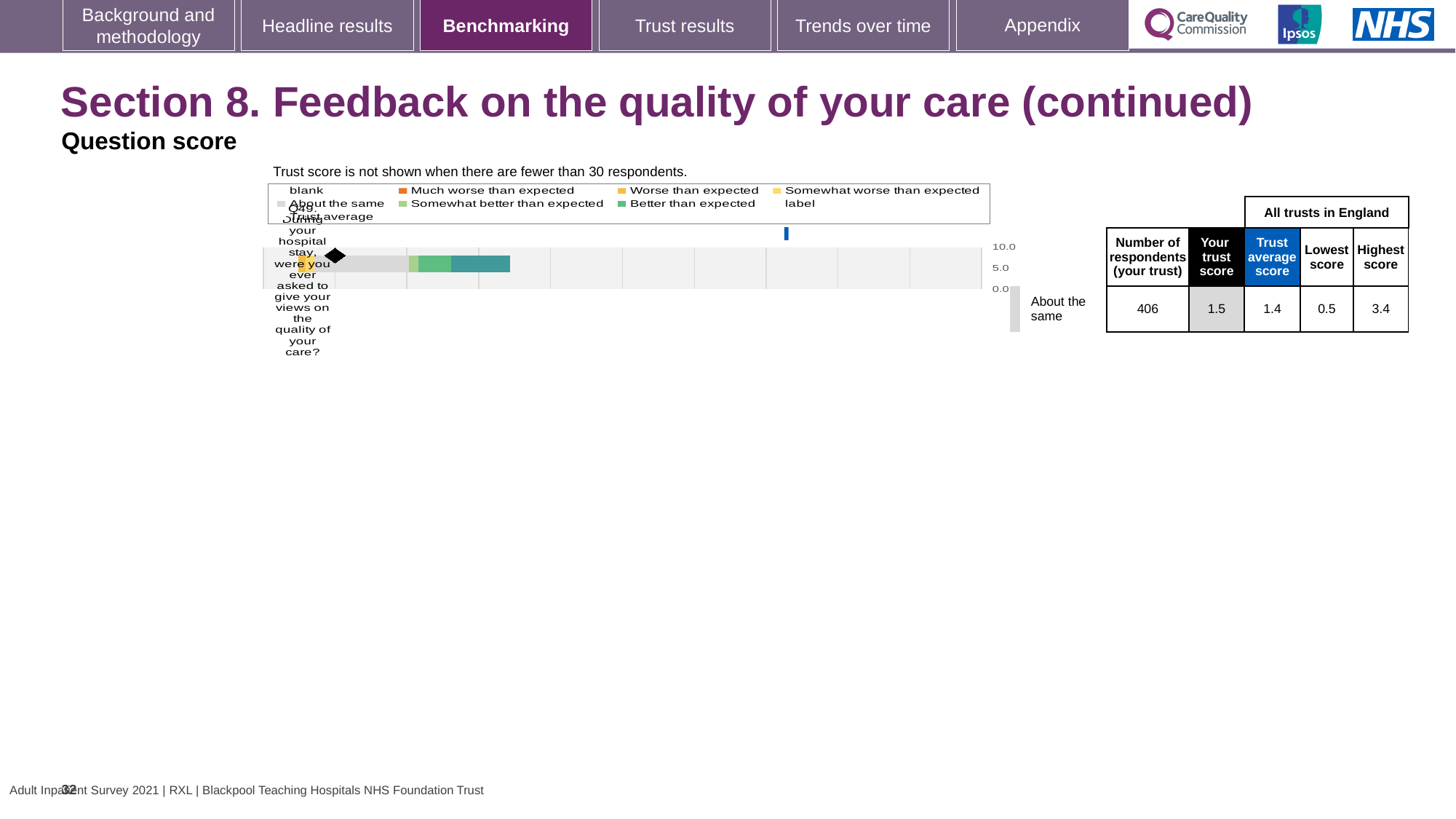
Which legend entry is shown in orange? Much worse than expected What kind of chart is shown on the slide? bar chart How many questions (categories) are plotted in the chart? 1 Which benchmark category is shown next to the chart for Q49? About the same Which question is plotted in the chart? Q49